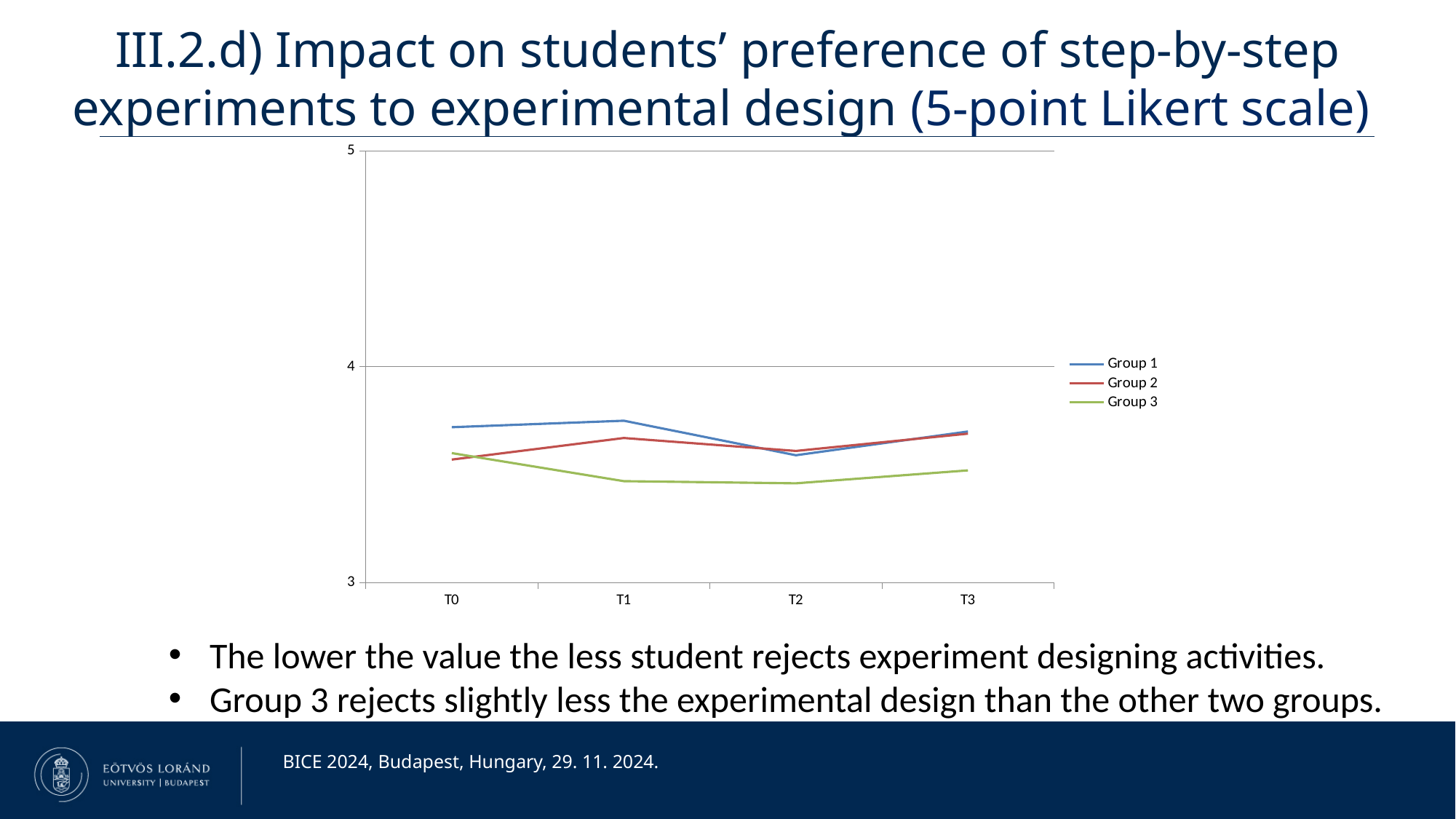
What colour is the line for Group 3? green Which series has the highest value at T0? Group 1 Which is larger at T1: the value for Group 1 or the value for Group 3? Group 1 How many series does the legend list? 3 What kind of chart is shown on the slide? line chart Does the value for Group 1 rise or fall from T1 to T2? fall How many time points are shown on the x axis? 4 Which series has the lowest value at T1? Group 3 Which series has the lowest value at T3? Group 3 Is the value for Group 1 at T1 greater or less than 4? less Does the value for Group 3 rise or fall from T0 to T1? fall Is the value for Group 3 at T2 greater or less than 3? greater